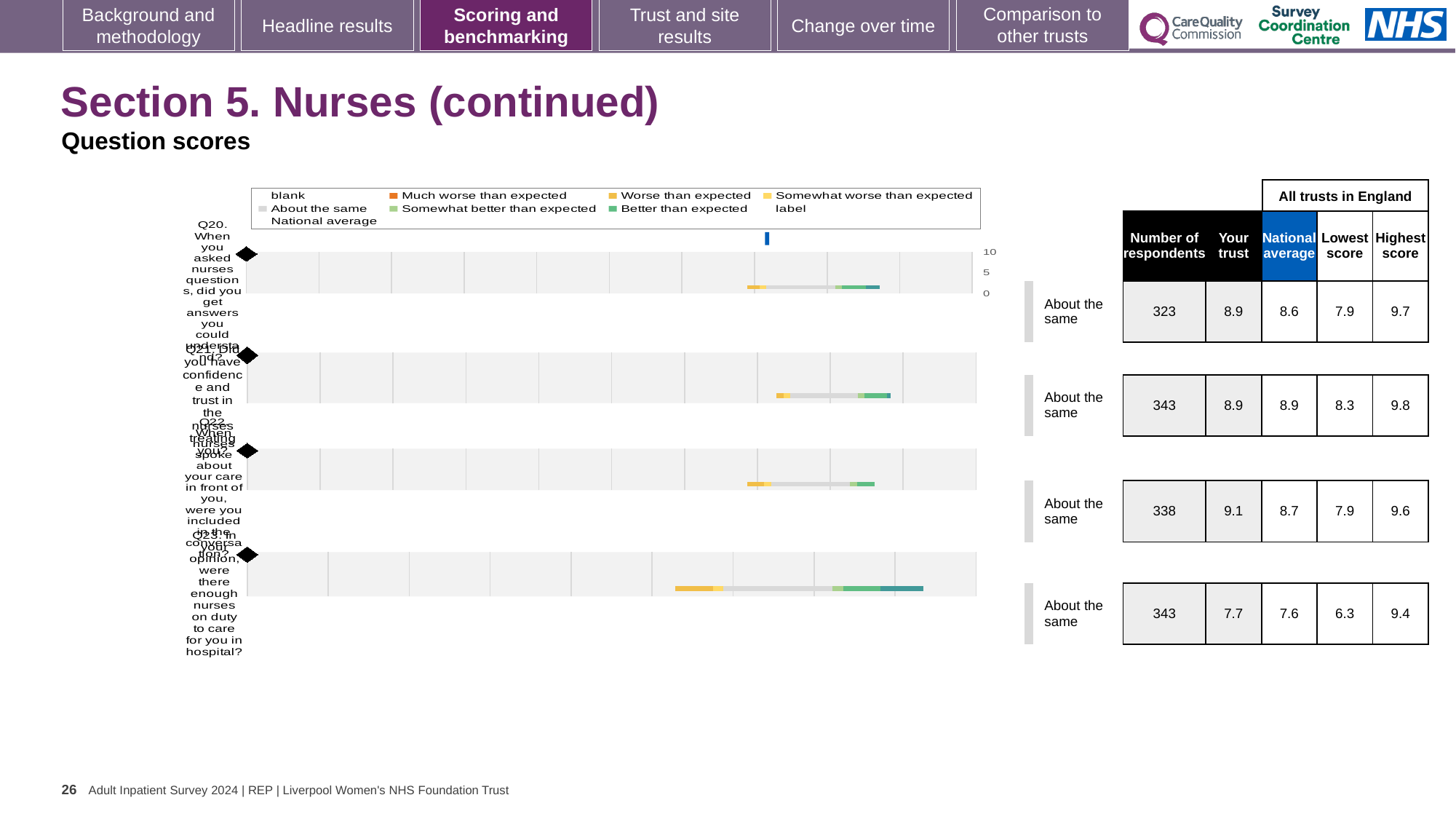
In the table, which question has the lowest 'Your trust' score? Q23 How many question bars (Q20 to Q23) are plotted in the chart? 4 In the table, is the 'Your trust' score for Q22 larger or smaller than the national average for Q22? larger Which legend entry is shown with an orange colour? Much worse than expected In the table, what is the 'Your trust' score for Q20? 8.9 What kind of chart is shown on the slide? bar chart In the table, which question has the highest 'Your trust' score? Q22 In the table, what is the national average for Q22? 8.7 What is the highest tick value shown on the chart's axis? 10 In the table, what is the number of respondents for Q23? 343 What benchmark category is given for all four questions on the slide? About the same In the table, what is the difference between the highest score and the lowest score for Q21? 1.5